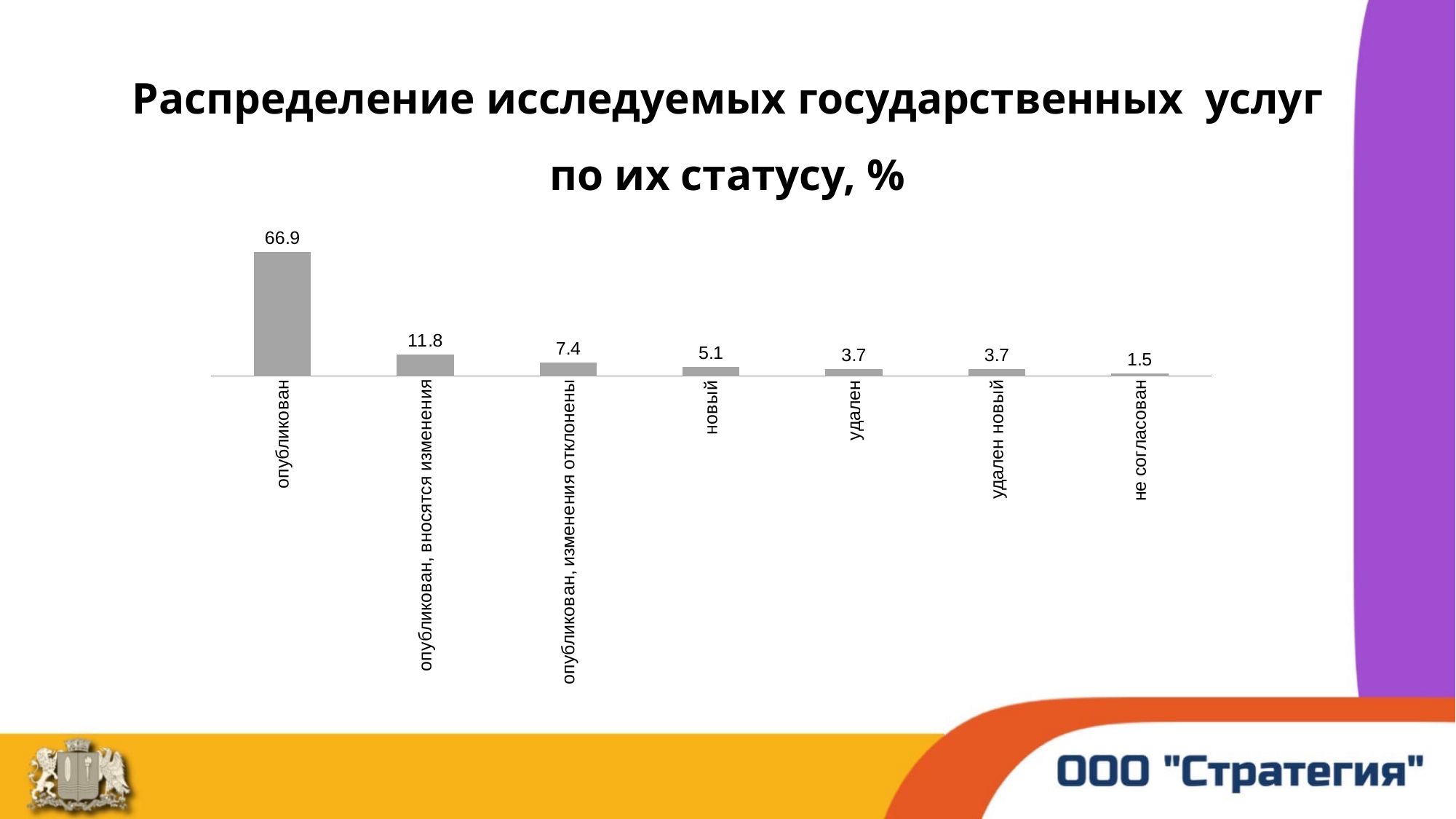
What kind of chart is shown on the slide? bar chart Which category has the lowest value? не согласован Which is larger, the value for "новый" or the value for "удален"? новый What is the value for the category "опубликован"? 66.9 What is the title of the chart? Распределение исследуемых государственных услуг по их статусу, % How many categories are shown in the chart? 7 What is the value for the category "новый"? 5.1 What is the value for the category "не согласован"? 1.5 What is the difference between the values for "опубликован" and "опубликован, вносятся изменения"? 55.1 What is the difference between the values for "опубликован, изменения отклонены" and "новый"? 2.3 Which category has the highest value? опубликован What is the value for the category "опубликован, вносятся изменения"? 11.8